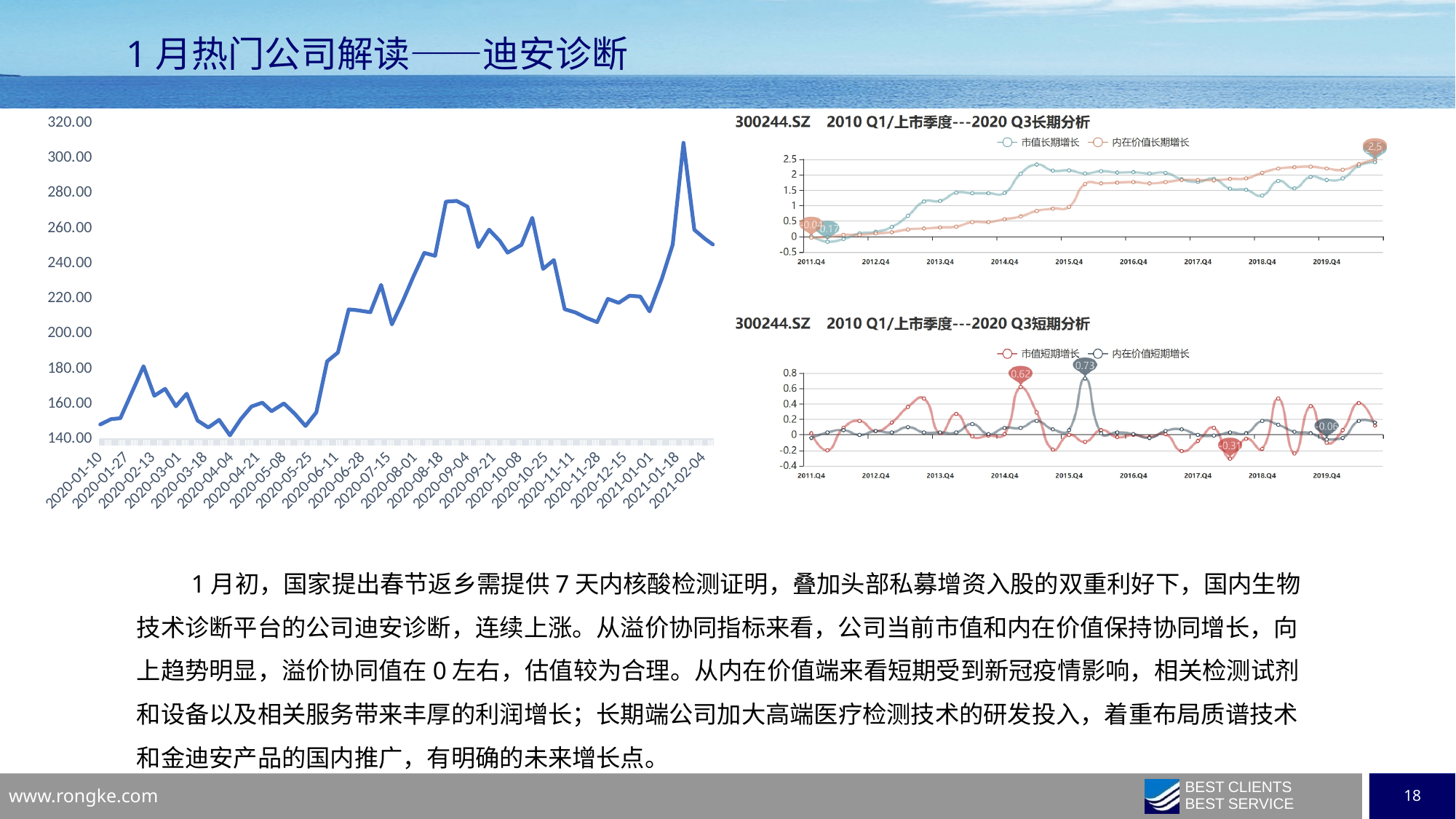
In the chart on the left side of the slide, do the values overall rise or fall from 2020-01-10 to 2021-02-04? rise In the chart on the left side of the slide, is the value at 2020-01-10 greater or less than 160.00? less What kind of chart is the chart on the left side of the slide? line chart How many series does the legend of the chart titled '300244.SZ 2010 Q1/上市季度---2020 Q3长期分析' list? 2 In the chart titled '300244.SZ 2010 Q1/上市季度---2020 Q3长期分析', what is the highest labeled value shown? 2.5 In the chart titled '300244.SZ 2010 Q1/上市季度---2020 Q3短期分析', what is the highest labeled value shown? 0.73 In the chart titled '300244.SZ 2010 Q1/上市季度---2020 Q3短期分析', what is the difference between the labeled peaks 0.73 and 0.62? 0.11 In the chart titled '300244.SZ 2010 Q1/上市季度---2020 Q3短期分析', which series has the higher labeled peak, 市值短期增长 or 内在价值短期增长? 内在价值短期增长 In the chart titled '300244.SZ 2010 Q1/上市季度---2020 Q3短期分析', what is the lowest labeled value shown? -0.31 How many series does the legend of the chart titled '300244.SZ 2010 Q1/上市季度---2020 Q3短期分析' list? 2 What are the two legend entries in the chart titled '300244.SZ 2010 Q1/上市季度---2020 Q3长期分析'? 市值长期增长 and 内在价值长期增长